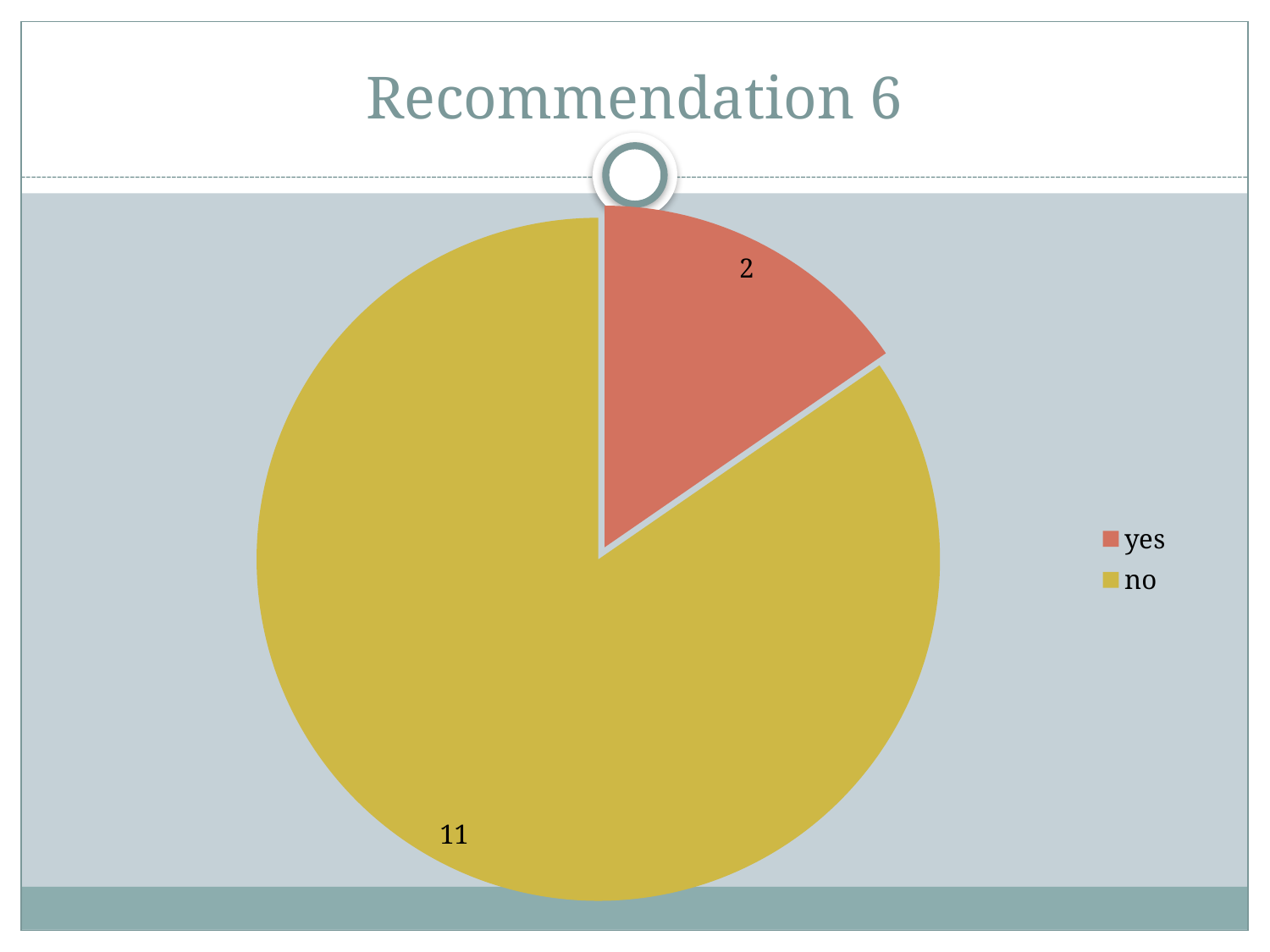
Which category has the largest slice in the pie chart? no What kind of chart is shown on the slide? pie chart What is the value for "no" in the pie chart? 11 Which is larger, the value for "yes" or the value for "no"? no Which category has the smallest slice in the pie chart? yes What is the value for "yes" in the pie chart? 2 What colour is the "yes" slice in the pie chart? red What is the total of all slices in the pie chart? 13 What is the difference between the "no" and "yes" values? 9 What is the title of the slide containing the pie chart? Recommendation 6 How many categories does the pie chart show? 2 What share of the pie does the "no" slice represent? 11 of 13